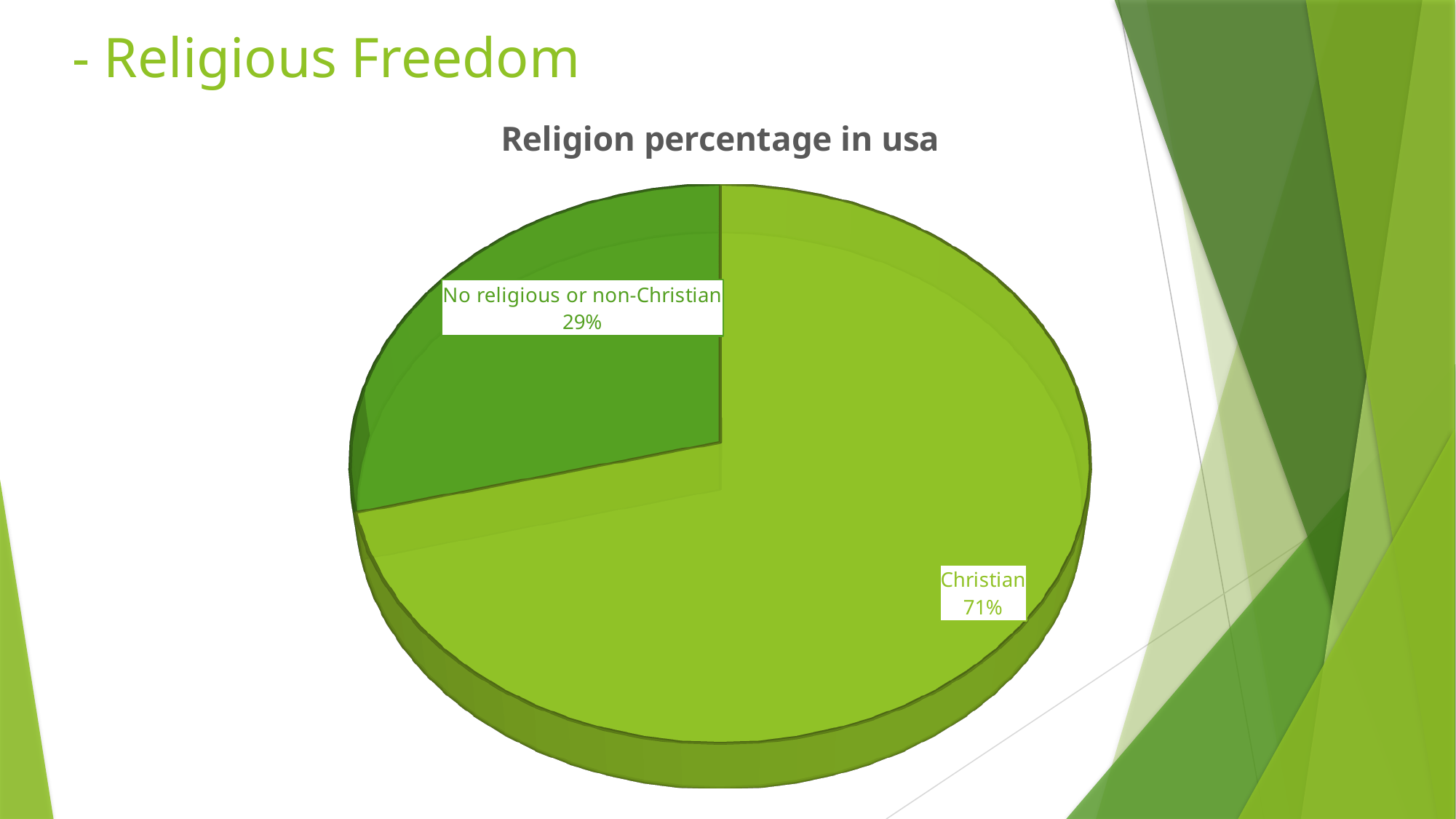
Which slice is the largest in the pie chart? Christian What percentage does the 'No religious or non-Christian' slice represent? 29% Which is larger, the Christian slice or the 'No religious or non-Christian' slice? Christian What kind of chart is shown on the slide? pie chart What is the title of the chart? Religion percentage in usa What share of the pie does the Christian slice take up? 71% Is the value for 'No religious or non-Christian' greater or less than 50%? less What is the difference in percentage points between the Christian slice and the 'No religious or non-Christian' slice? 42 Which slice is the smallest in the pie chart? No religious or non-Christian How many slices does the pie chart have? 2 What percentage does the Christian slice represent? 71%